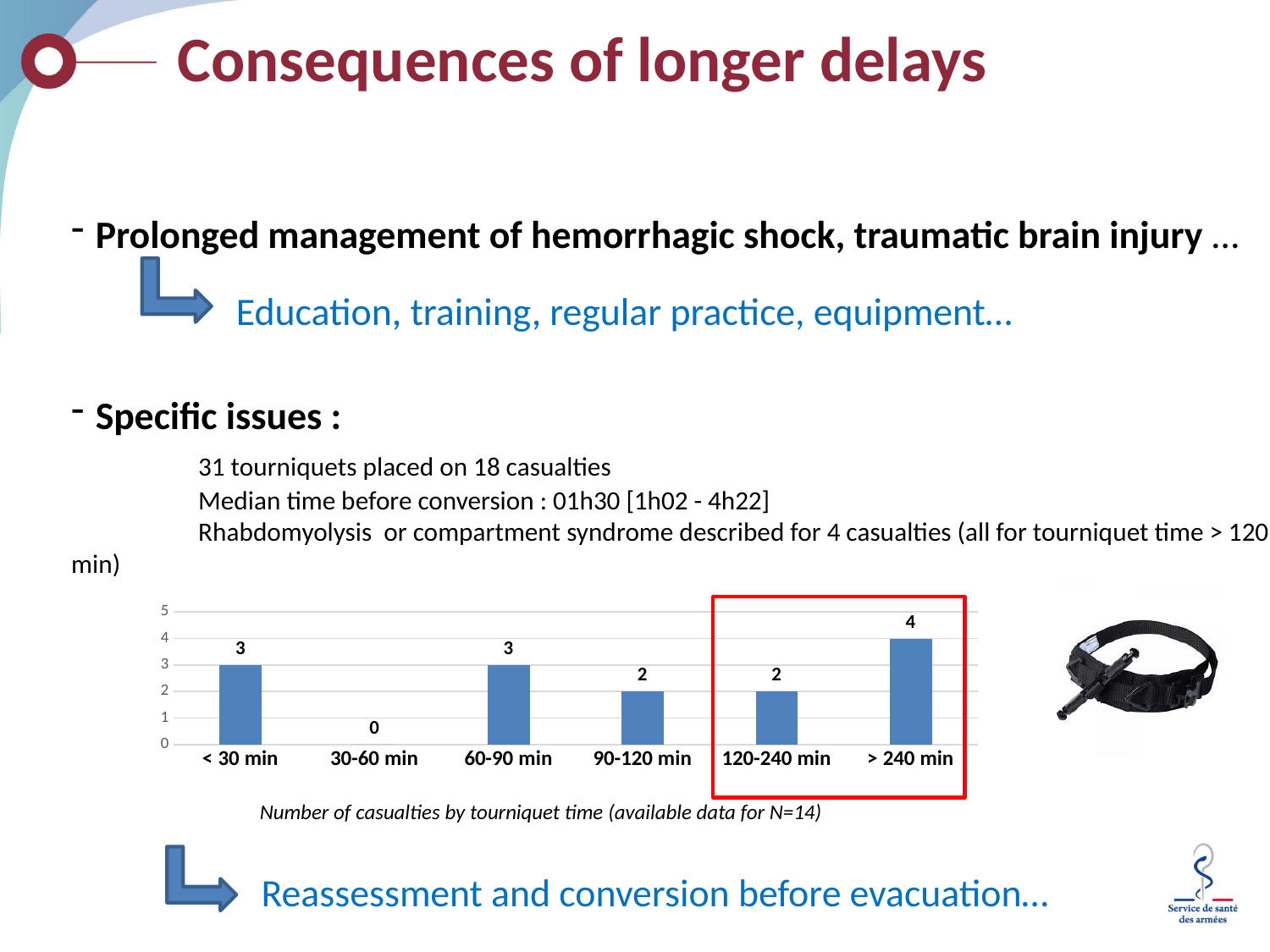
What is the number of casualties for the < 30 min tourniquet time category? 3 Which tourniquet time category has the lowest number of casualties? 30-60 min What is the number of casualties for the 30-60 min category? 0 How many tourniquet time categories are shown on the x axis of the chart? 6 What is the total number of casualties across the two categories inside the red box (120-240 min and > 240 min)? 6 What is the difference between the number of casualties for > 240 min and for 120-240 min? 2 Which has more casualties: 60-90 min or 90-120 min? 60-90 min What is the caption below the chart? Number of casualties by tourniquet time (available data for N=14) Which tourniquet time category has the highest number of casualties? > 240 min What is the number of casualties for the 90-120 min category? 2 What is the number of casualties for the > 240 min category? 4 What type of chart is shown on the slide? bar chart